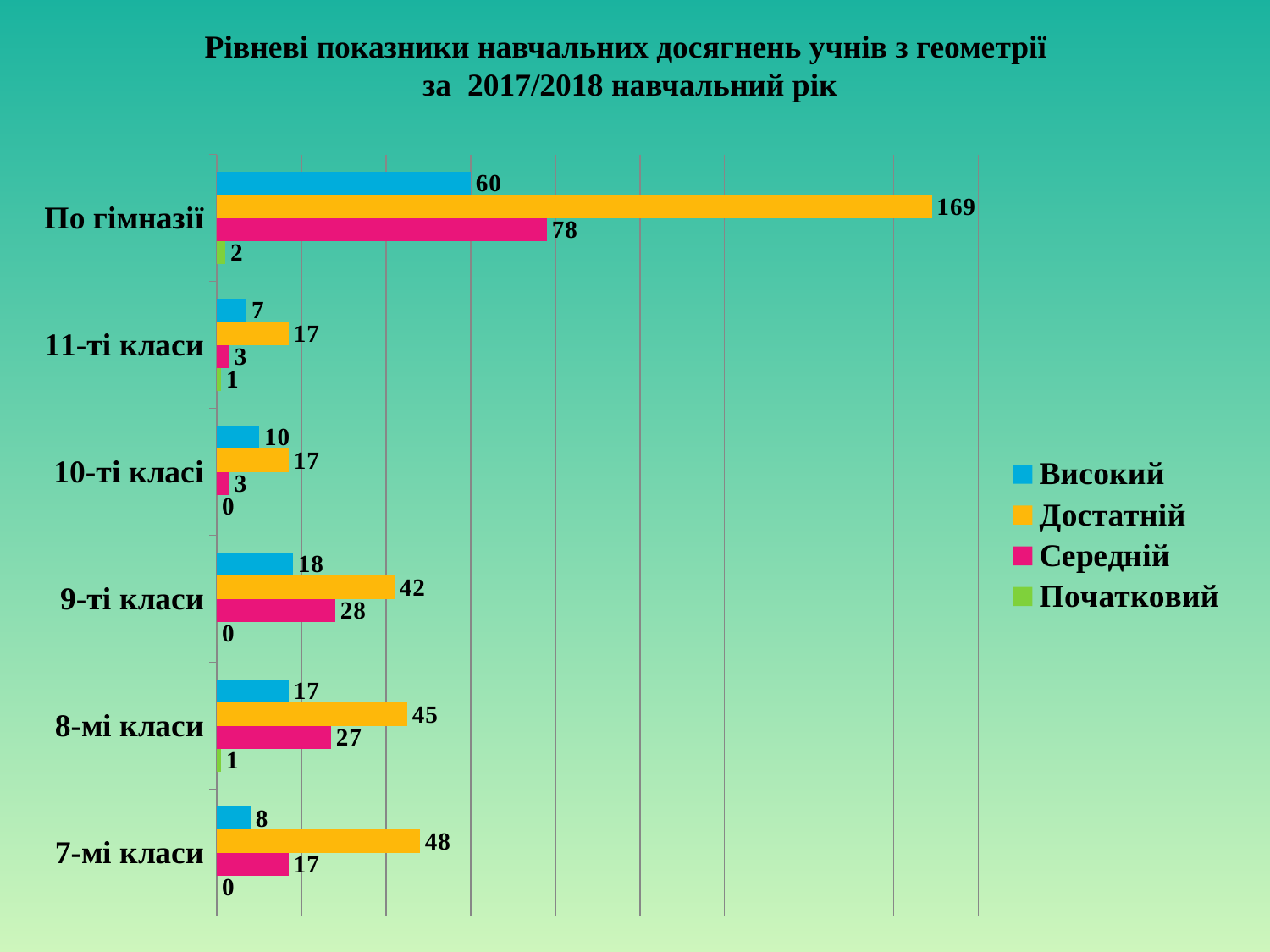
How many series does the legend list? 4 What is the value of Середній for 9-ті класи? 28 What kind of chart is shown on the slide? bar chart What is the value of Початковий for 8-мі класи? 1 Which category has the lowest Високий value? 11-ті класи What is the difference between the Достатній and Середній values for По гімназії? 91 Which is larger for 8-мі класи: Високий or Середній? Середній What is the total of the four series for 9-ті класи? 88 What is the value of Достатній for По гімназії? 169 What is the value of Високий for 7-мі класи? 8 Which category has the highest Достатній value among the class groups (excluding По гімназії)? 7-мі класи How many categories are shown on the chart? 6